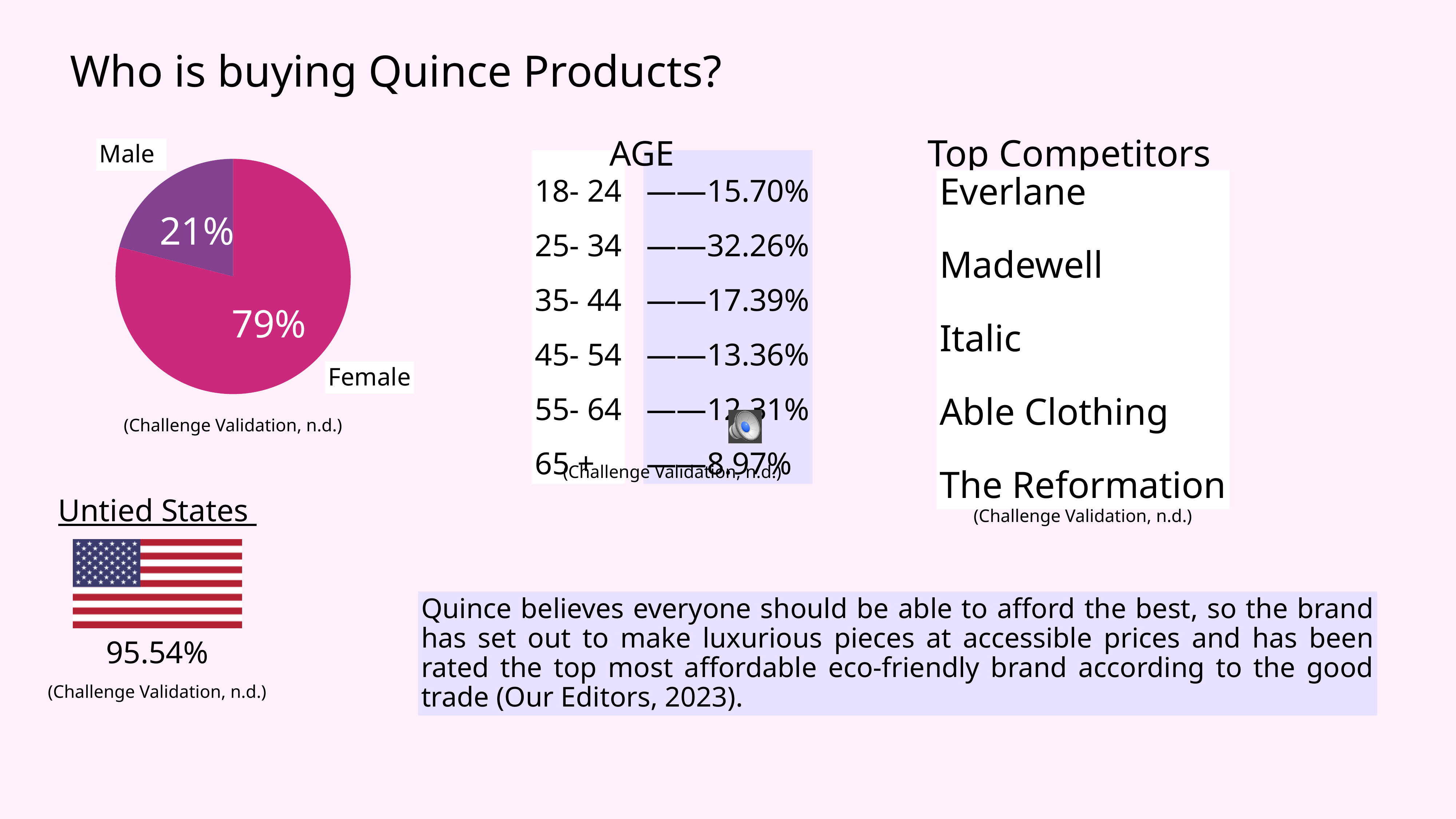
In the pie chart, which is larger, the Male slice or the Female slice? Female Which slice of the pie chart is the smallest? Male In the pie chart, what percentage is labelled for Female? 79% In the pie chart, by how many percentage points does the Female share exceed the Male share? 58 percentage points What share of the pie chart does the Female slice represent? 79% What colour is the Male slice in the pie chart? Purple How many slices does the pie chart have? 2 What colour is the Female slice in the pie chart? Pink (magenta) Which slice of the pie chart is the largest? Female In the pie chart, what percentage is labelled for Male? 21% What kind of chart is shown on the left of the slide? Pie chart